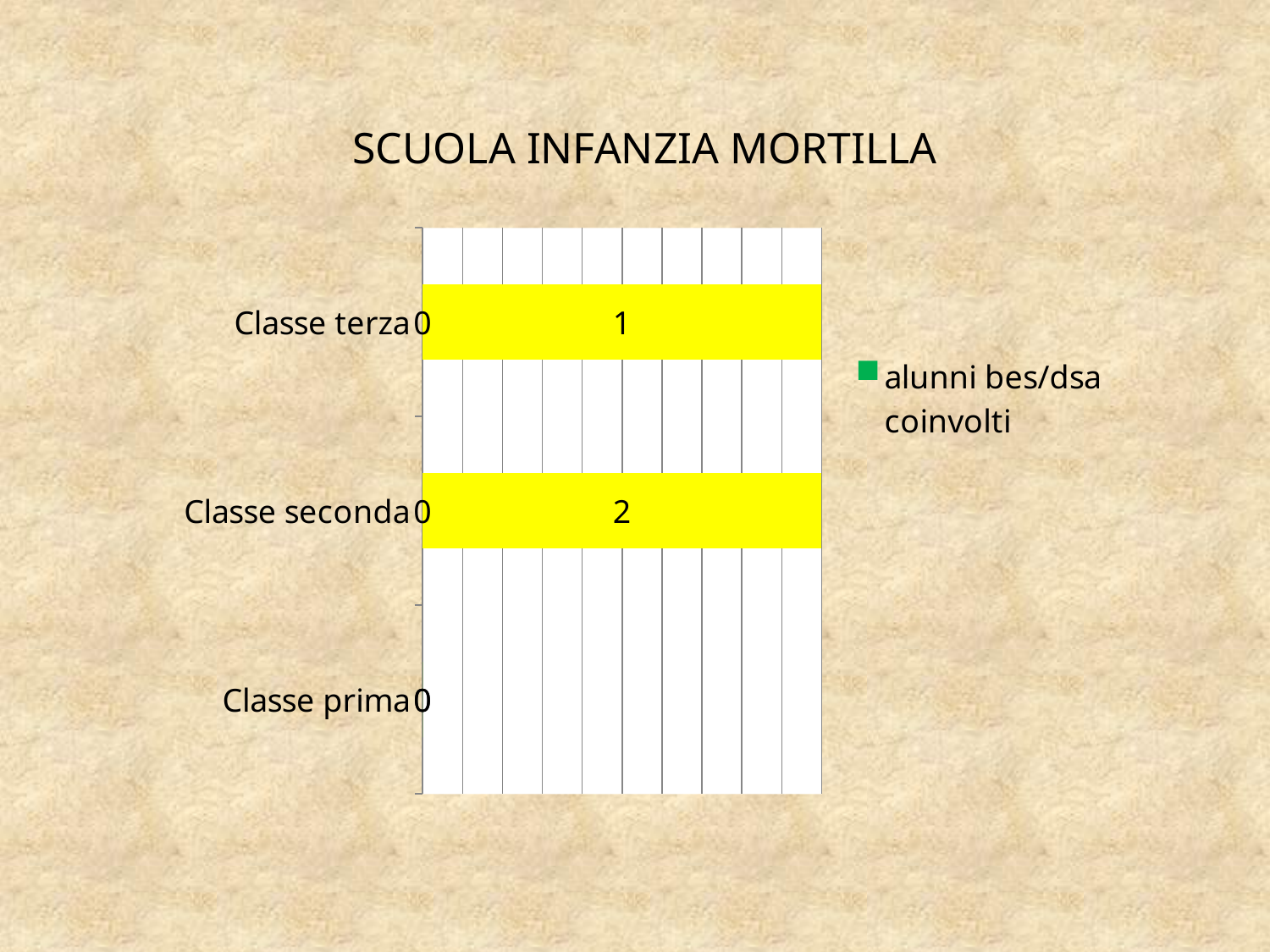
Which class has the highest labelled value on its yellow bar? Classe seconda Which class has no yellow bar in the chart? Classe prima Which has a larger labelled value, Classe terza or Classe seconda? Classe seconda What kind of chart is shown on the slide? Bar chart What value is labelled on the yellow bar for Classe seconda? 2 How many classes are listed on the vertical axis of the chart? 3 What value is labelled on the yellow bar for Classe terza? 1 How many series does the legend list? 1 What is the title of the chart? SCUOLA INFANZIA MORTILLA What is the legend entry shown next to the chart? alunni bes/dsa coinvolti What is the difference between the labelled values for Classe seconda and Classe terza? 1